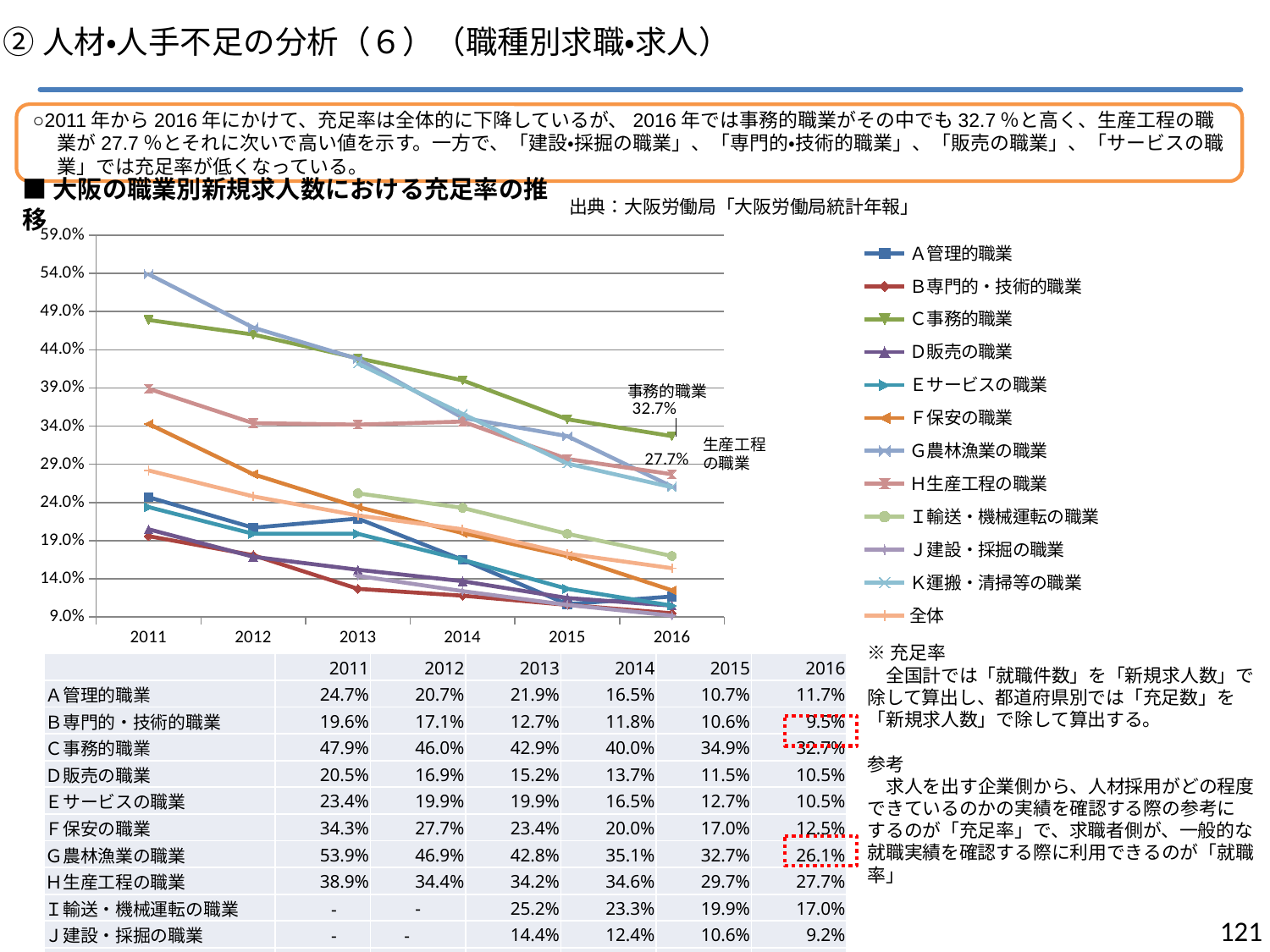
How many years are shown along the x axis of the chart? 6 Which is larger in 2014, F保安の職業 or Eサービスの職業? F保安の職業 Which occupation has the highest value in 2011? G農林漁業の職業 Is the value for C事務的職業 in 2011 greater or less than 44.0%? greater What is the value for H生産工程の職業 in 2016? 27.7% What is the value for C事務的職業 in 2016? 32.7% Does the value for G農林漁業の職業 rise or fall from 2011 to 2016? fall Which occupation has the lowest value in 2016? J建設・採掘の職業 What is the value for G農林漁業の職業 in 2011? 53.9% How many series does the chart's legend list? 12 What is the difference between C事務的職業 and H生産工程の職業 in 2016? 5.0% What kind of chart is shown on the slide? line chart